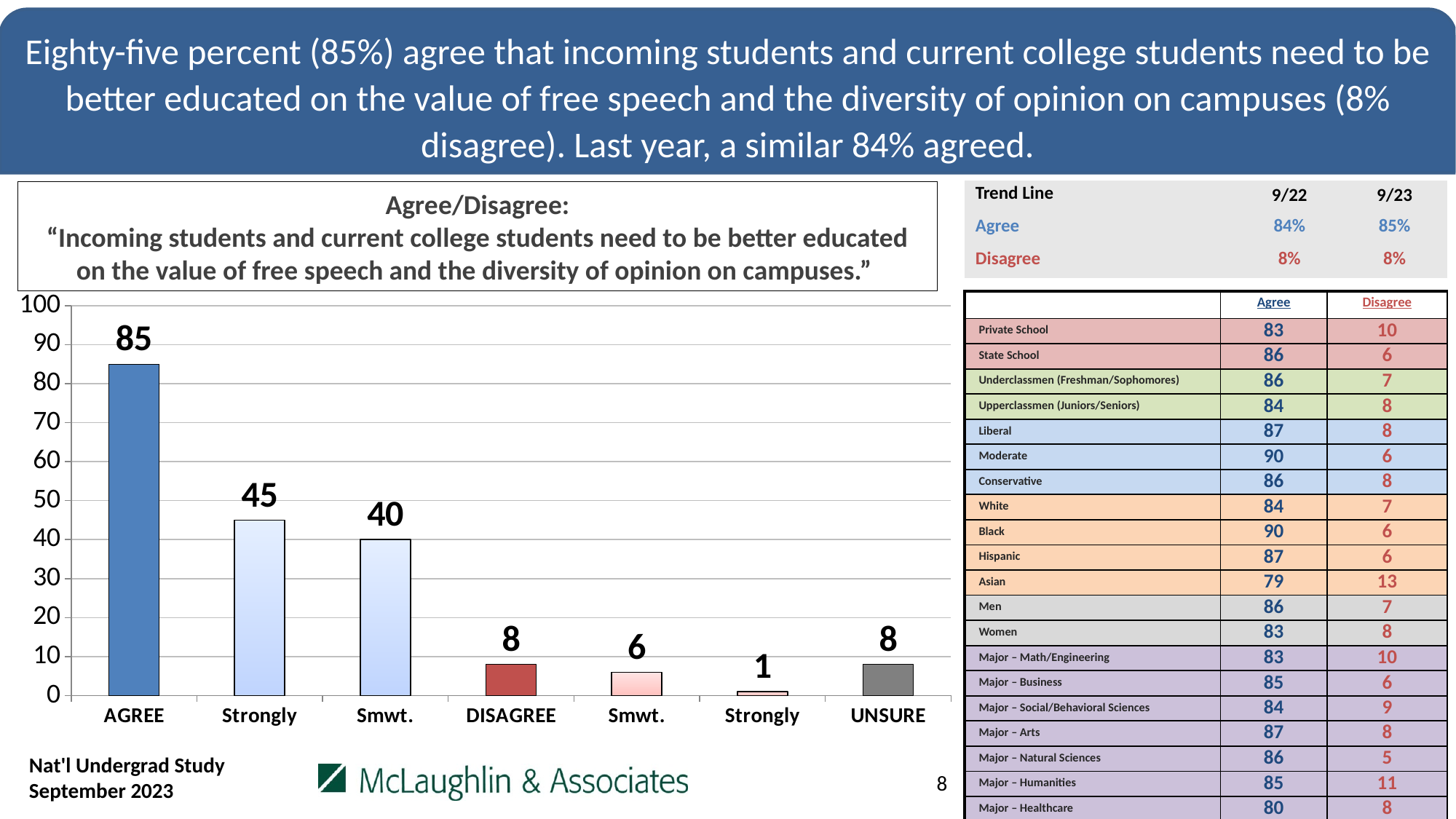
What is the value of the AGREE bar? 85 What is the difference between the AGREE and DISAGREE bars? 77 How many bars are shown in the chart? 7 Which is larger, the Smwt. disagree bar or the UNSURE bar? UNSURE Which category has the highest bar? AGREE What kind of chart is shown on the slide? Bar chart What is the value of the UNSURE bar? 8 What is the value of the Strongly bar under AGREE (the second bar)? 45 What is the difference between the Strongly agree bar (45) and the Smwt. agree bar (40)? 5 What is the value of the DISAGREE bar? 8 What is the highest value shown on the chart's vertical axis? 100 Which category has the lowest bar? Strongly (under DISAGREE)